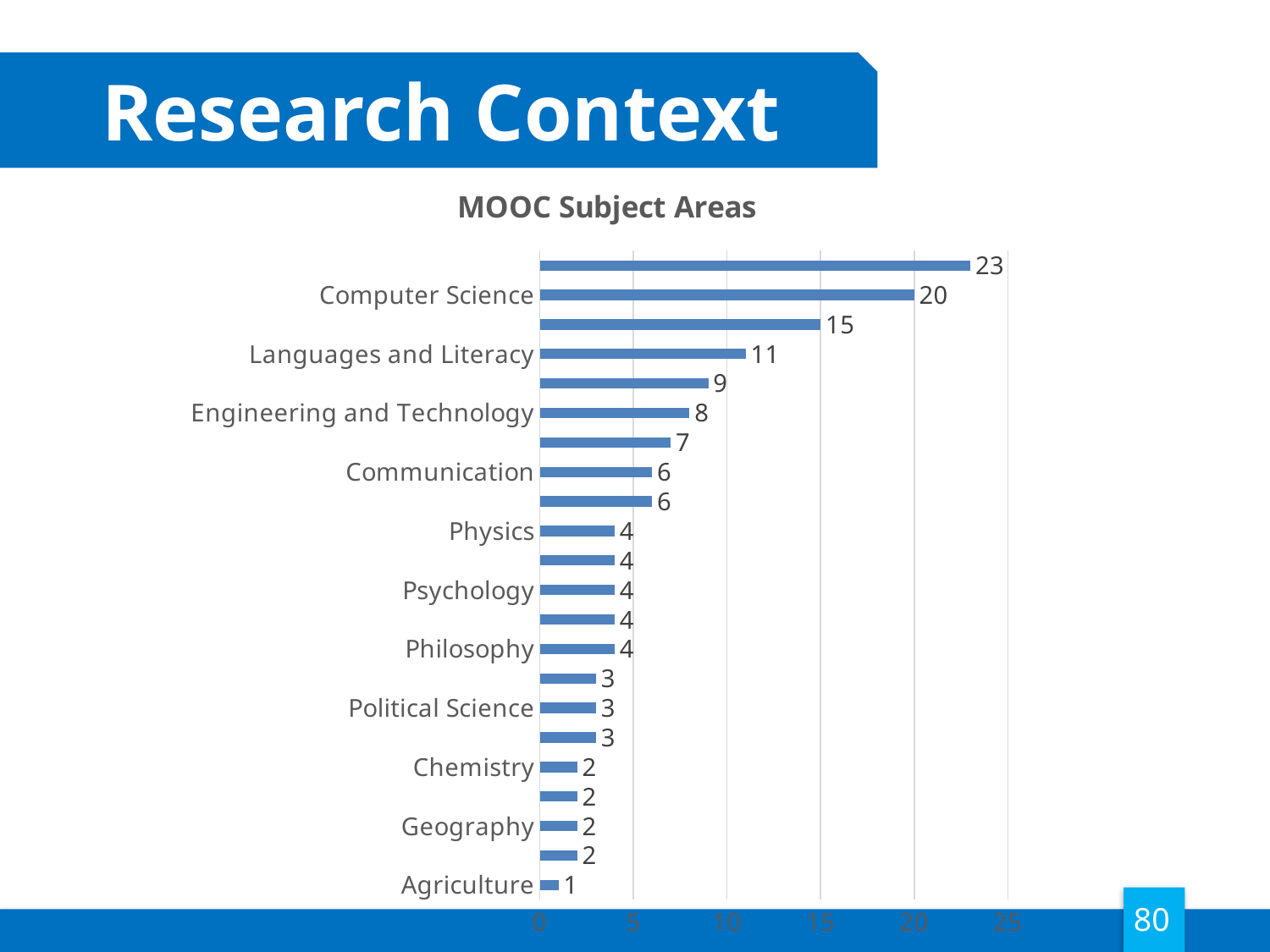
What is the value for Agriculture? 1 Which is larger, the value for Physics or the value for Chemistry? Physics Which labeled subject area has the lowest value? Agriculture What is the value for Engineering and Technology? 8 What is the value for Computer Science? 20 What is the largest value shown on the chart? 23 What is the value for Communication? 6 What is the value for Languages and Literacy? 11 What is the title of the chart? MOOC Subject Areas How many bars are plotted on the chart? 22 What kind of chart is shown on the slide? bar chart What is the difference between the values for Computer Science and Languages and Literacy? 9